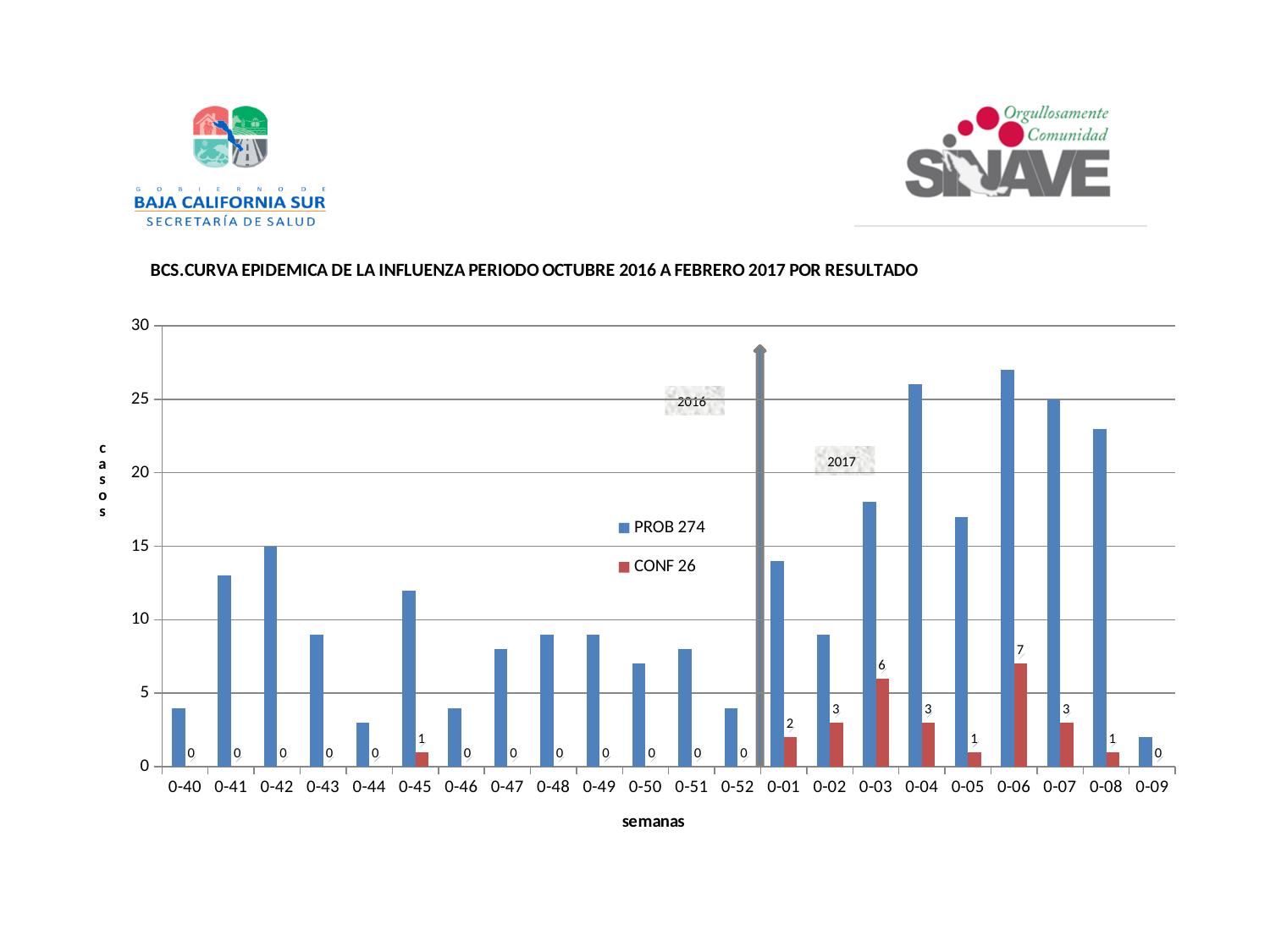
Which week has the highest CONF 26 value? 0-06 Is the PROB 274 value for week 0-06 greater or less than 25? greater What is the CONF 26 value for week 0-03? 6 What is the CONF 26 value for week 0-06? 7 What is the CONF 26 value for week 0-45? 1 How many weeks (categories) are shown on the x axis? 22 Which week has the larger CONF 26 value, 0-01 or 0-02? 0-02 What are the two series named in the legend? PROB 274 and CONF 26 Is the PROB 274 value for week 0-44 greater or less than 5? less How many series does the legend list? 2 What is the difference between the CONF 26 values for weeks 0-06 and 0-03? 1 What kind of chart is shown on the slide? bar chart